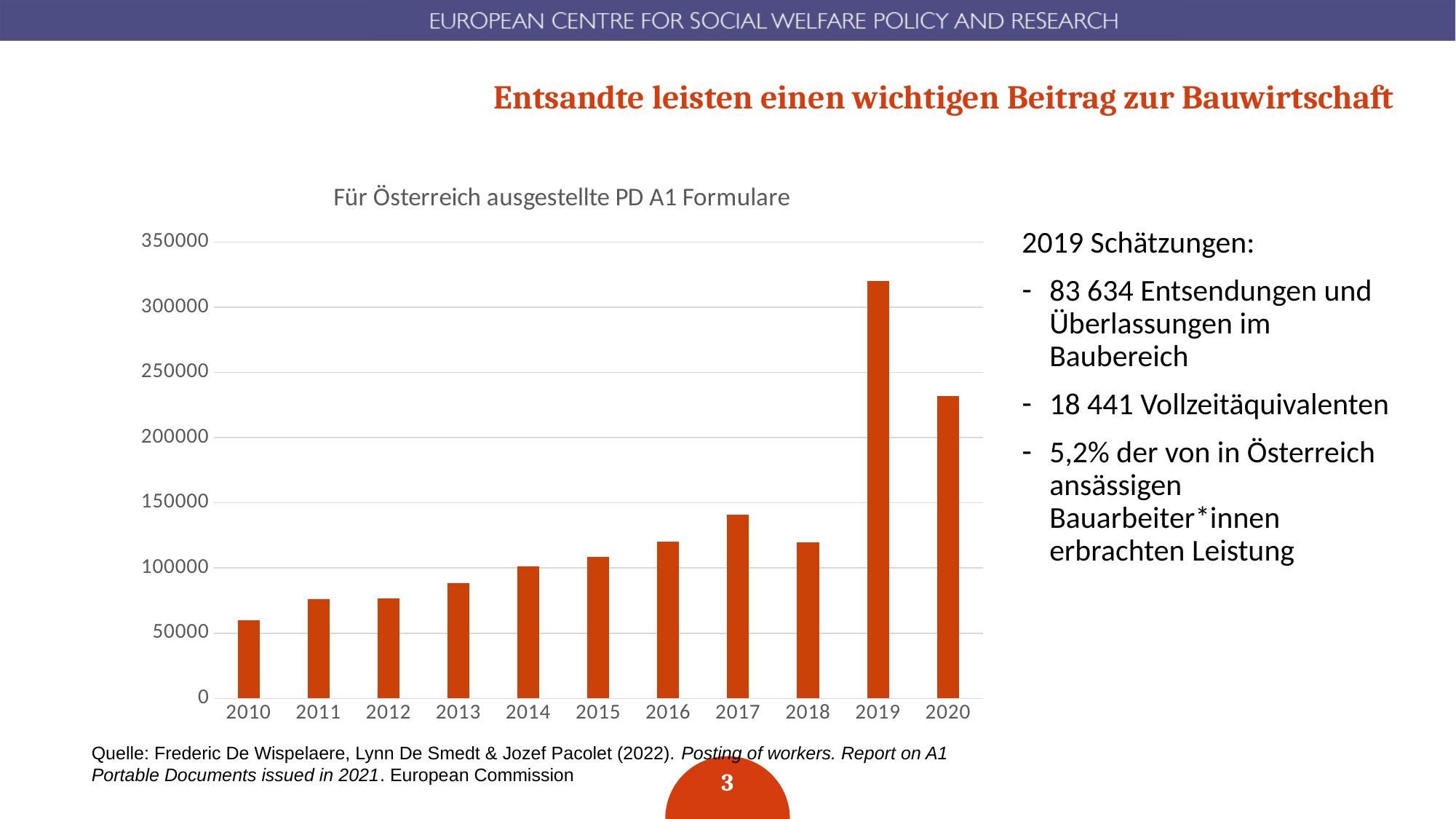
Is the value for 2010 greater or less than 100000? less Which year has the larger value, 2017 or 2018? 2017 Which year has the larger value, 2019 or 2020? 2019 What is the title of the chart? Für Österreich ausgestellte PD A1 Formulare Which year has the lowest bar in the chart? 2010 Which year has the highest bar in the chart? 2019 Do the values rise or fall from 2010 to 2017? rise What kind of chart is shown on the slide? bar chart Is the value for 2017 greater or less than 150000? less Is the value for 2019 greater or less than 300000? greater How many years are shown on the x axis of the chart? 11